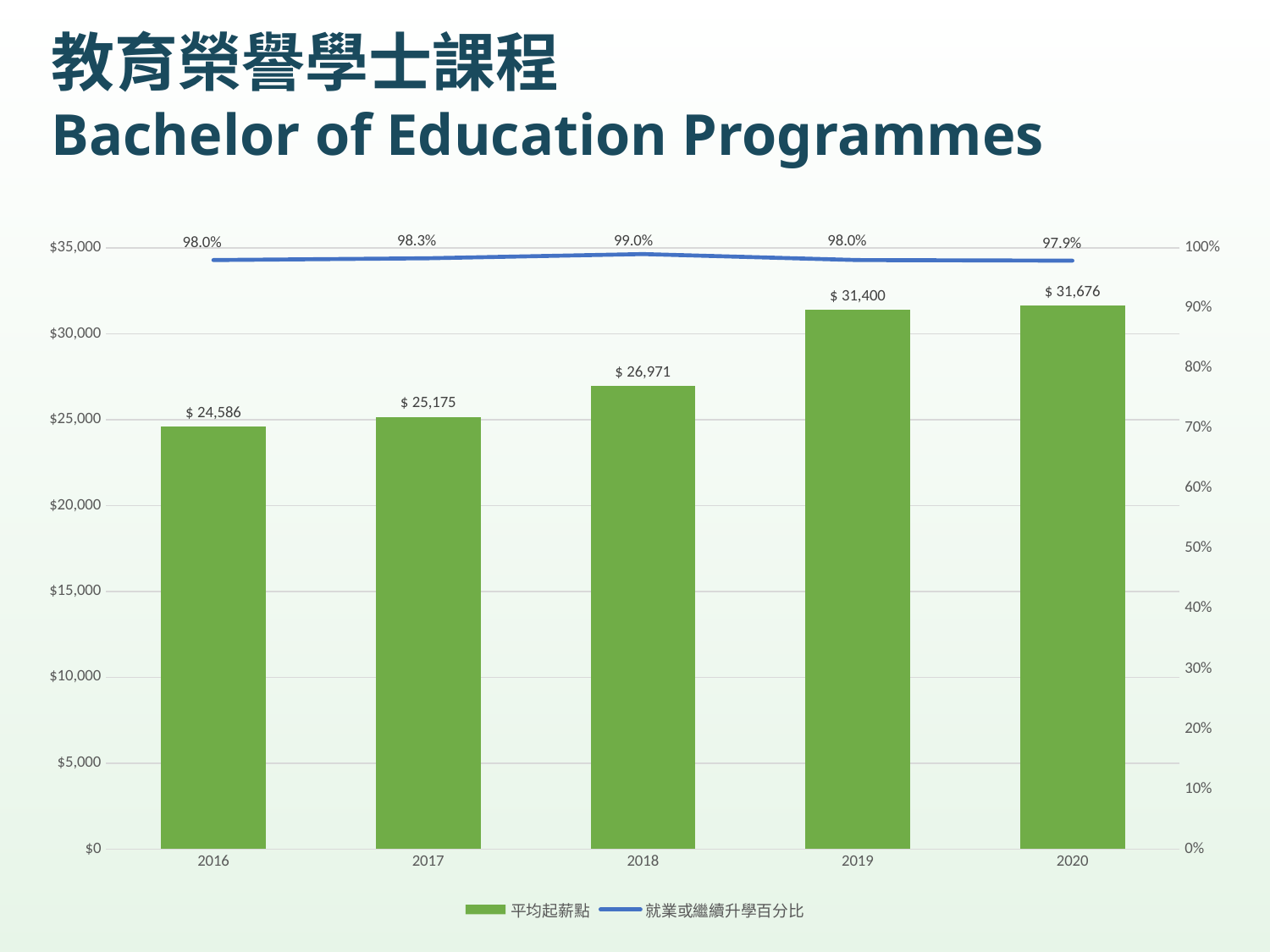
How many years are shown on the x axis of the chart? 5 Which year has the highest employment or further study percentage? 2018 Does the average starting salary rise or fall from 2016 to 2020? rise What is the average starting salary (平均起薪點) shown for 2018? $ 26,971 What is the average starting salary (平均起薪點) shown for 2020? $ 31,676 What employment or further study percentage (就業或繼續升學百分比) is shown for 2020? 97.9% Which year has the highest average starting salary? 2020 What employment or further study percentage (就業或繼續升學百分比) is shown for 2018? 99.0% Is the average starting salary higher in 2017 or in 2018? 2018 How many series does the legend list? 2 Which year has the lowest average starting salary? 2016 What is the difference between the average starting salary in 2019 and in 2016? $ 6,814